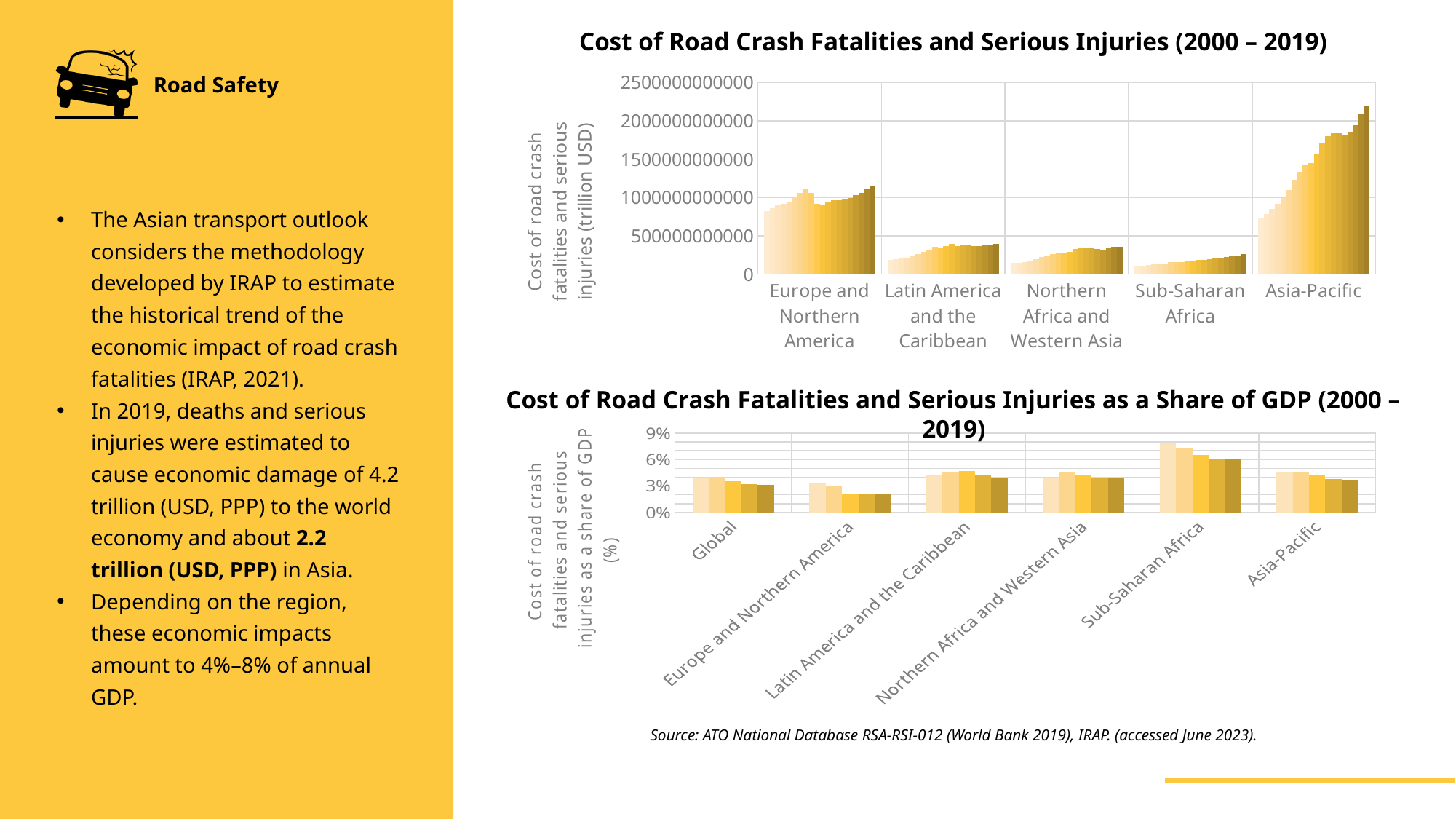
How many regions are shown on the x axis of the top chart, 'Cost of Road Crash Fatalities and Serious Injuries (2000 – 2019)'? 5 In the bottom chart, 'Cost of Road Crash Fatalities and Serious Injuries as a Share of GDP (2000 – 2019)', which region has the highest share of GDP? Sub-Saharan Africa In the bottom chart, 'Cost of Road Crash Fatalities and Serious Injuries as a Share of GDP (2000 – 2019)', which region has the lowest share of GDP? Europe and Northern America In the top chart, 'Cost of Road Crash Fatalities and Serious Injuries (2000 – 2019)', do the values for Asia-Pacific rise or fall over the period? Rise How many regions are shown on the x axis of the bottom chart, 'Cost of Road Crash Fatalities and Serious Injuries as a Share of GDP (2000 – 2019)'? 6 In the top chart, 'Cost of Road Crash Fatalities and Serious Injuries (2000 – 2019)', which region has the lowest cost? Sub-Saharan Africa In the top chart, 'Cost of Road Crash Fatalities and Serious Injuries (2000 – 2019)', which region has higher costs: Latin America and the Caribbean or Sub-Saharan Africa? Latin America and the Caribbean What kind of chart is the top chart, 'Cost of Road Crash Fatalities and Serious Injuries (2000 – 2019)'? Bar chart In the top chart, 'Cost of Road Crash Fatalities and Serious Injuries (2000 – 2019)', which region has the highest cost in the most recent year? Asia-Pacific In the top chart, 'Cost of Road Crash Fatalities and Serious Injuries (2000 – 2019)', is the latest value for Asia-Pacific greater or less than 20000000000000? greater In the top chart, 'Cost of Road Crash Fatalities and Serious Injuries (2000 – 2019)', are the values for Europe and Northern America greater or less than 15000000000000? less In the bottom chart, 'Cost of Road Crash Fatalities and Serious Injuries as a Share of GDP (2000 – 2019)', do the values for Sub-Saharan Africa rise or fall over the period? Fall